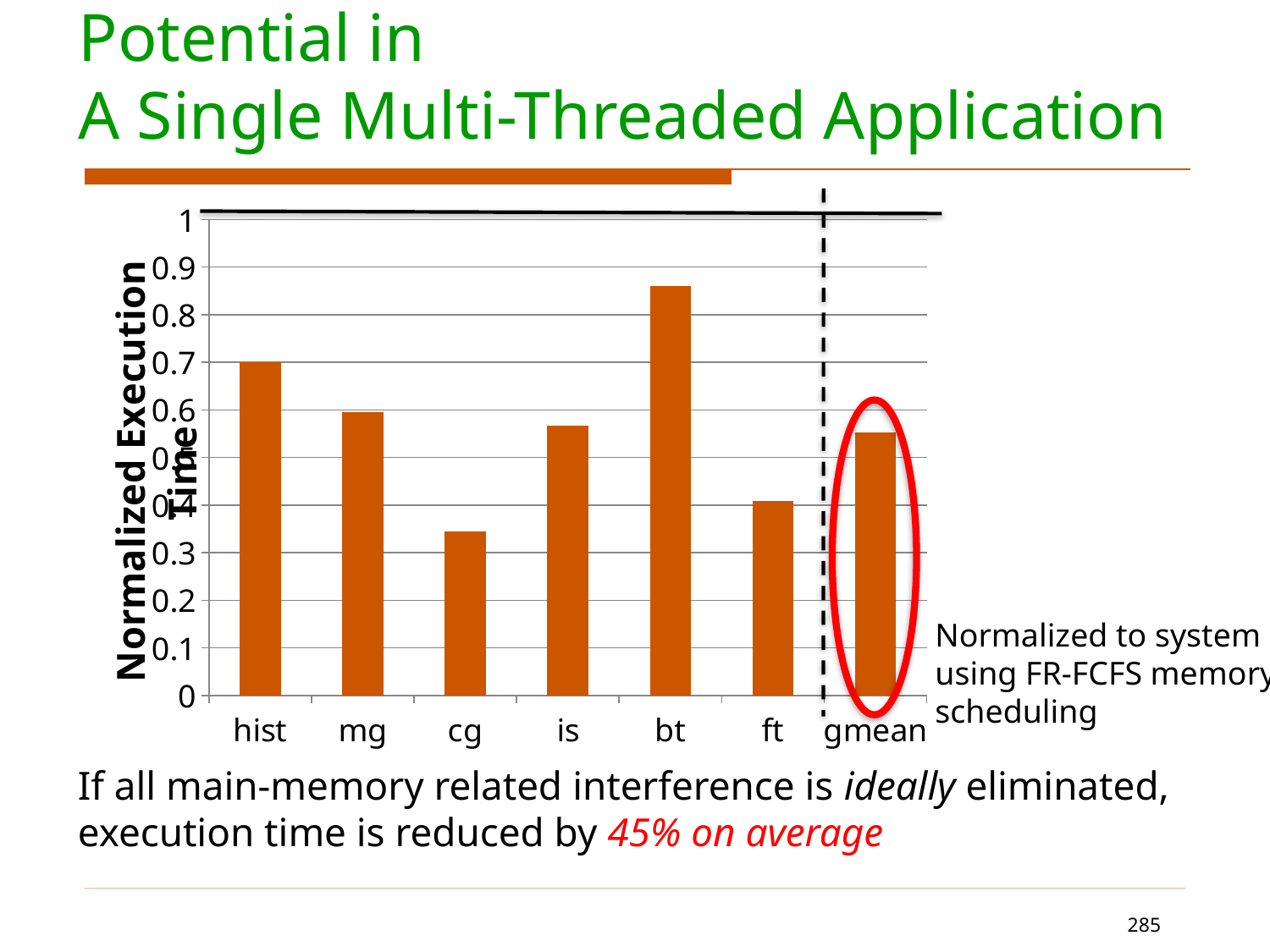
Which category has the lowest normalized execution time? cg What kind of chart is shown on the slide? bar chart What is the label of the y axis of the chart? Normalized Execution Time Which category has the highest normalized execution time? bt Is the value for ft greater or less than 0.5? less How many categories are shown on the x axis of the chart? 7 Is the value for hist greater or less than 0.6? greater Is the value for cg greater or less than 0.4? less Which category's bar is circled in red on the chart? gmean Which has the larger normalized execution time, bt or ft? bt Which has the larger normalized execution time, hist or mg? hist